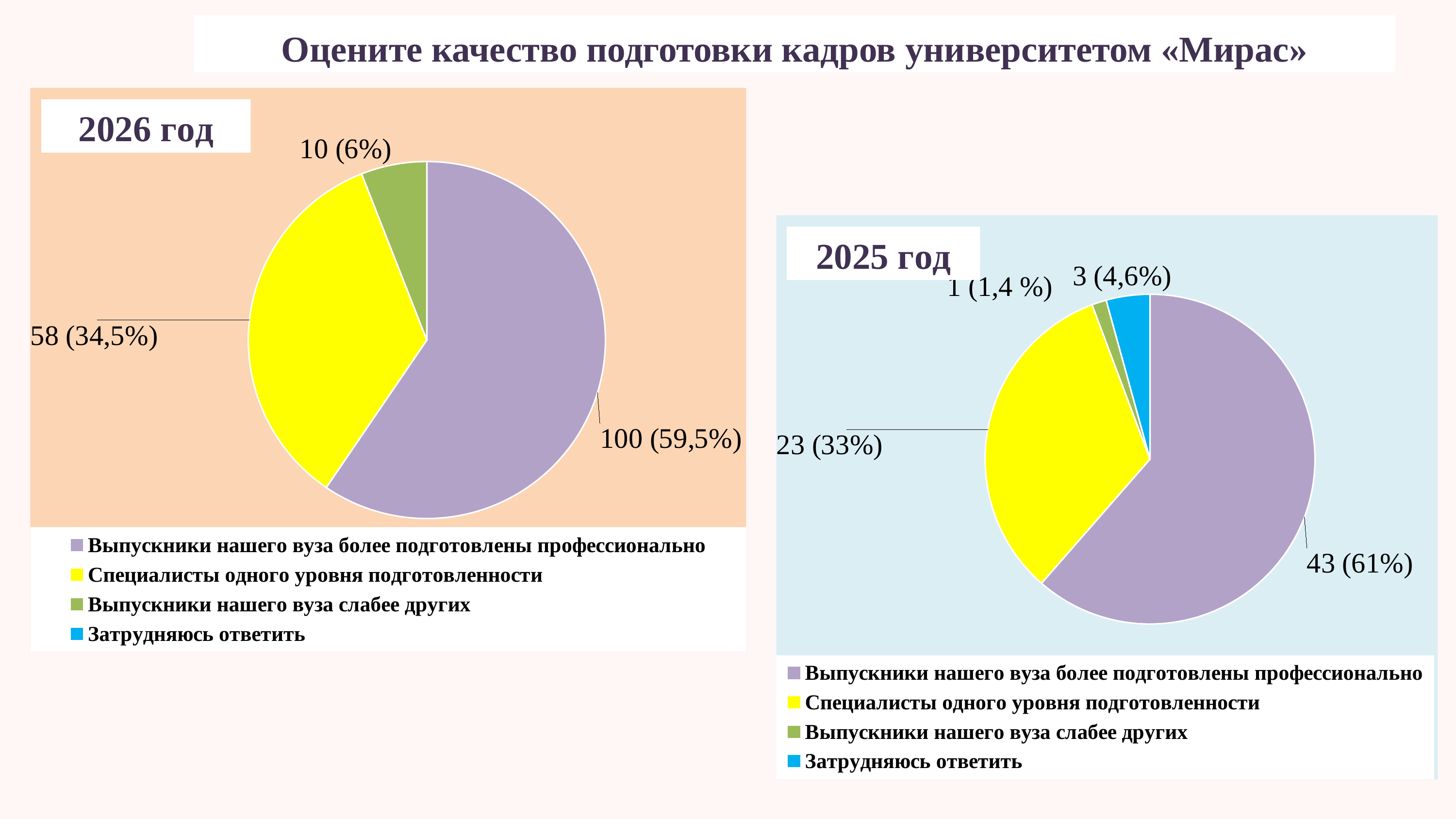
In the 2026 год chart, what is the value for «Специалисты одного уровня подготовленности»? 58 (34,5%) What kind of chart is shown for 2026 год? pie chart In the 2026 год chart, what is the value for «Выпускники нашего вуза более подготовлены профессионально»? 100 (59,5%) In the 2025 год chart, what share of the pie does «Специалисты одного уровня подготовленности» take? 33% In the 2026 год chart, which category has the largest slice? Выпускники нашего вуза более подготовлены профессионально In the 2026 год chart, what is the value for «Выпускники нашего вуза слабее других»? 10 (6%) How many entries does the legend of the 2025 год chart list? 4 In the 2025 год chart, which category has the smallest slice? Выпускники нашего вуза слабее других In the 2025 год chart, what is the value for «Выпускники нашего вуза более подготовлены профессионально»? 43 (61%) In the 2025 год chart, what is the value for «Выпускники нашего вуза слабее других»? 1 (1,4 %) In the 2026 год chart, what is the difference between the counts for «Выпускники нашего вуза более подготовлены профессионально» and «Специалисты одного уровня подготовленности»? 42 In the 2025 год chart, what is the value for «Затрудняюсь ответить»? 3 (4,6%)